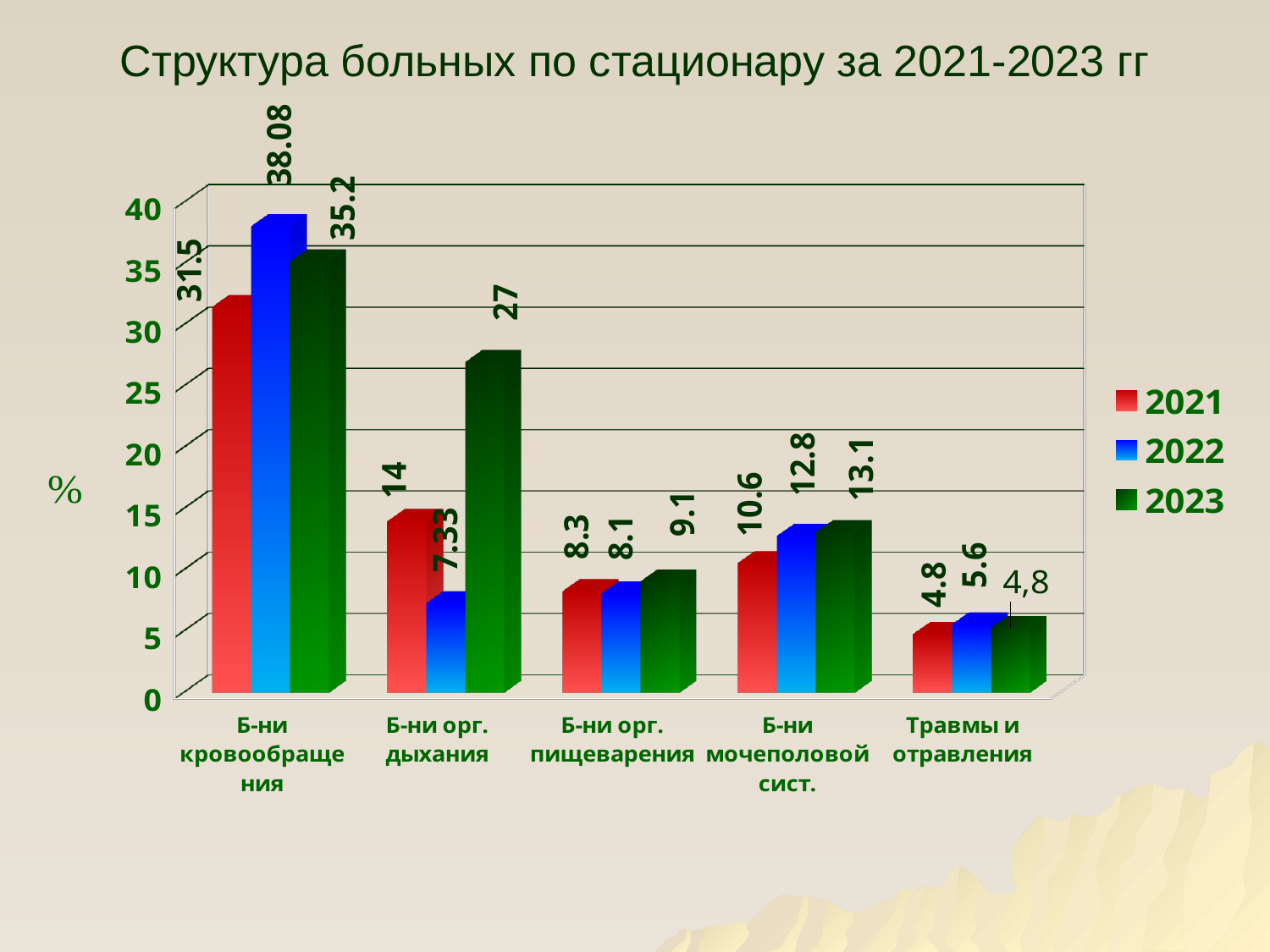
What is the value for Б-ни мочеполовой сист. in 2021? 10.6 What is the value for Травмы и отравления in 2022? 5.6 What kind of chart is shown on the slide? Bar chart Which category has the highest value in 2023? Б-ни кровообращения How many series does the legend list? 3 What is the value for Б-ни кровообращения in 2022? 38.08 Which category has the lowest value in 2021? Травмы и отравления What is the value for Б-ни орг. дыхания in 2023? 27 Which is larger for Б-ни кровообращения: the 2021 value or the 2023 value? 2023 What is the difference between the 2023 and 2022 values for Б-ни орг. дыхания? 19.67 What is the title of the chart? Структура больных по стационару за 2021-2023 гг How many categories are shown on the x axis? 5